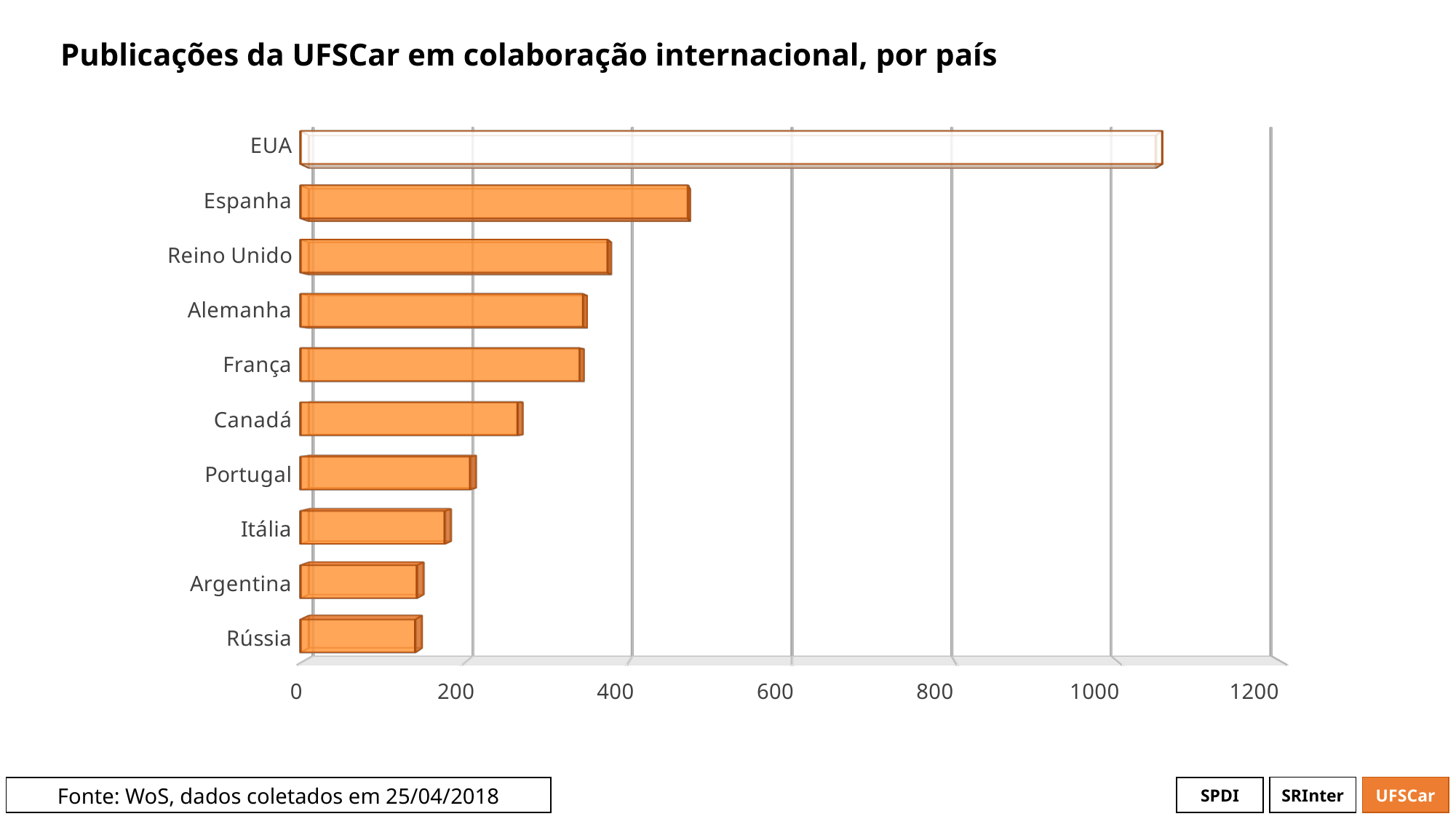
Which country has the highest number of publications in international collaboration? EUA Is the value for Rússia greater or less than 200? less Is the value for EUA greater or less than 1000? greater Is the value for Espanha greater or less than 400? greater What is the title of the chart? Publicações da UFSCar em colaboração internacional, por país How many countries are shown in the chart? 10 What is the data source cited on the slide? WoS, dados coletados em 25/04/2018 Which has more publications, Canadá or Portugal? Canadá What kind of chart is shown on the slide? bar chart Which has more publications, Espanha or Reino Unido? Espanha